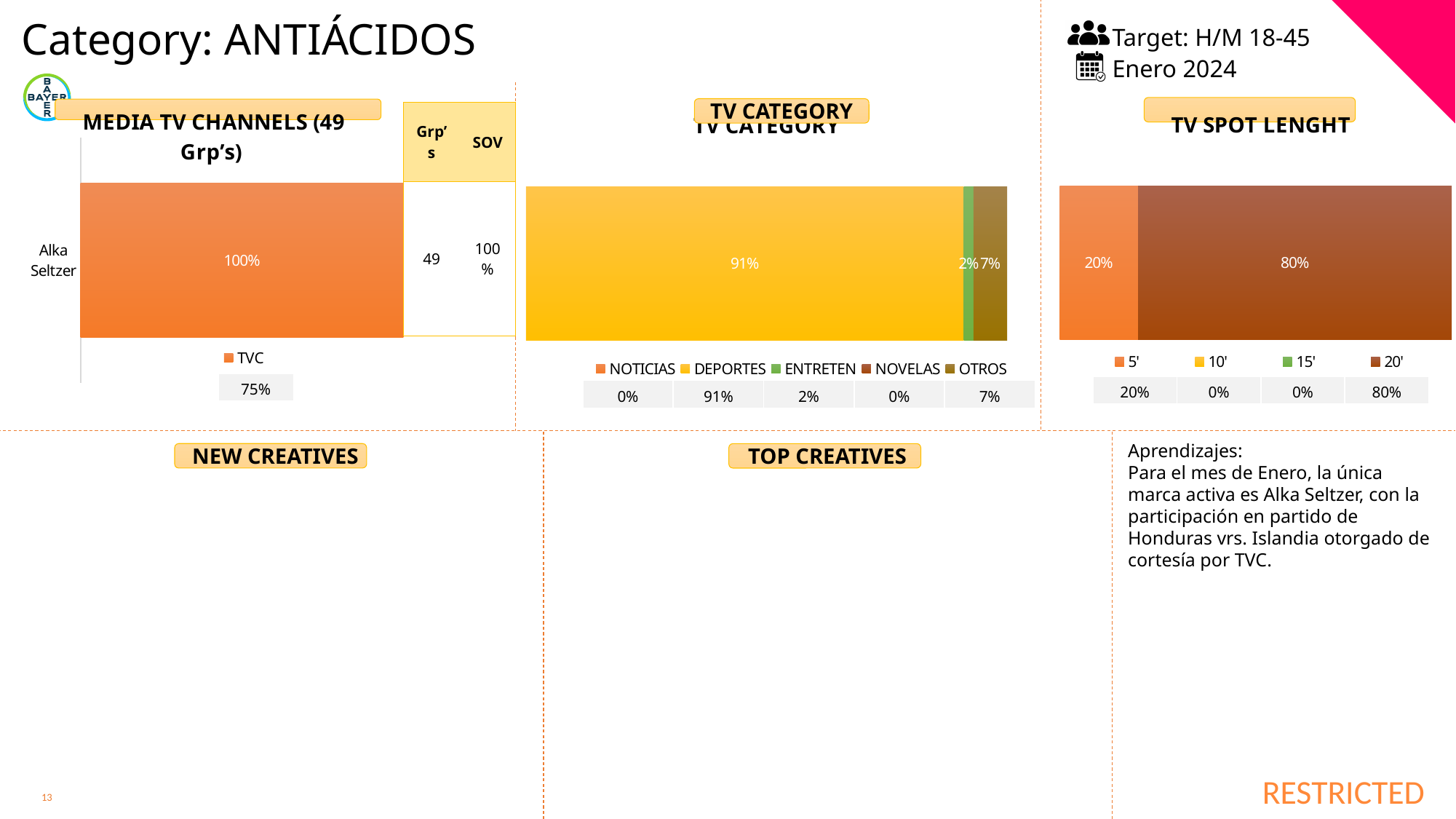
In the TV SPOT LENGHT chart, which is larger, the value for 5' or the value for 20'? 20' In the TV SPOT LENGHT chart, how many series does the legend list? 4 In the TV CATEGORY chart, how many series does the legend list? 5 In the TV CATEGORY chart, what is the value for OTROS? 7% What kind of chart is the TV CATEGORY chart? Stacked bar chart In the TV SPOT LENGHT chart, what is the value for 5'? 20% In the MEDIA TV CHANNELS chart, what is the value for TVC for Alka Seltzer? 100% In the TV CATEGORY chart, which category has the highest value? DEPORTES In the TV CATEGORY chart, what is the value for DEPORTES? 91% In the TV CATEGORY chart, what is the value for ENTRETEN? 2% In the TV CATEGORY chart, what is the difference between the DEPORTES and OTROS values? 84% In the TV SPOT LENGHT chart, what is the value for 20'? 80%